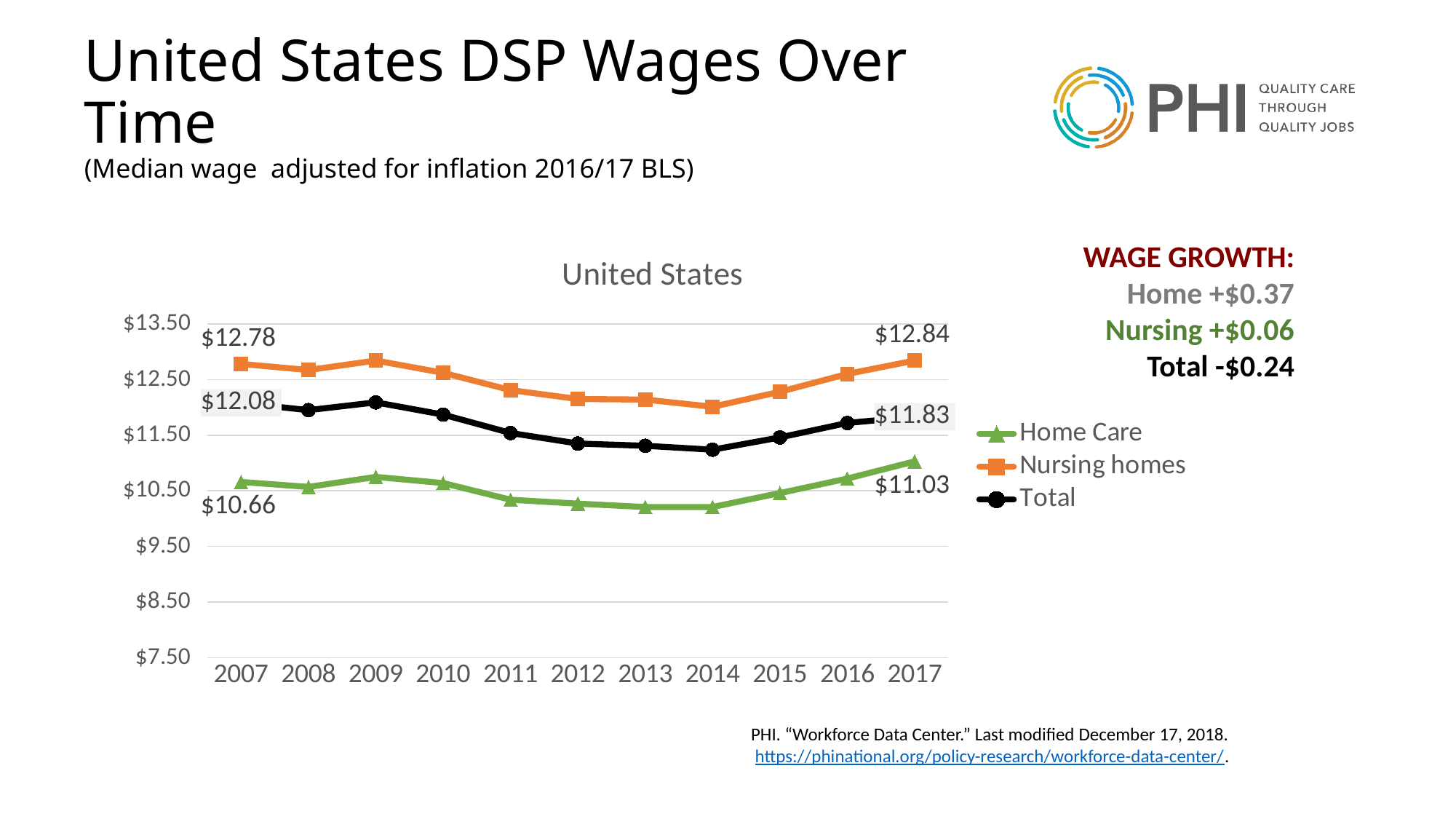
What is the difference between the Home Care values in 2017 and 2007? $0.37 What is the Nursing homes value for 2007? $12.78 What is the Total value for 2007? $12.08 Is the Total value for 2014 greater or less than $11.50? less What is the Total value for 2017? $11.83 What is the Home Care value for 2017? $11.03 Is the Home Care value for 2014 greater or less than $10.50? less By how much did the Nursing homes value change from 2007 to 2017? +$0.06 How many series does the legend list? 3 What kind of chart is shown? line chart In 2017, which is larger: the Nursing homes value or the Total value? Nursing homes How many years are shown on the x axis? 11